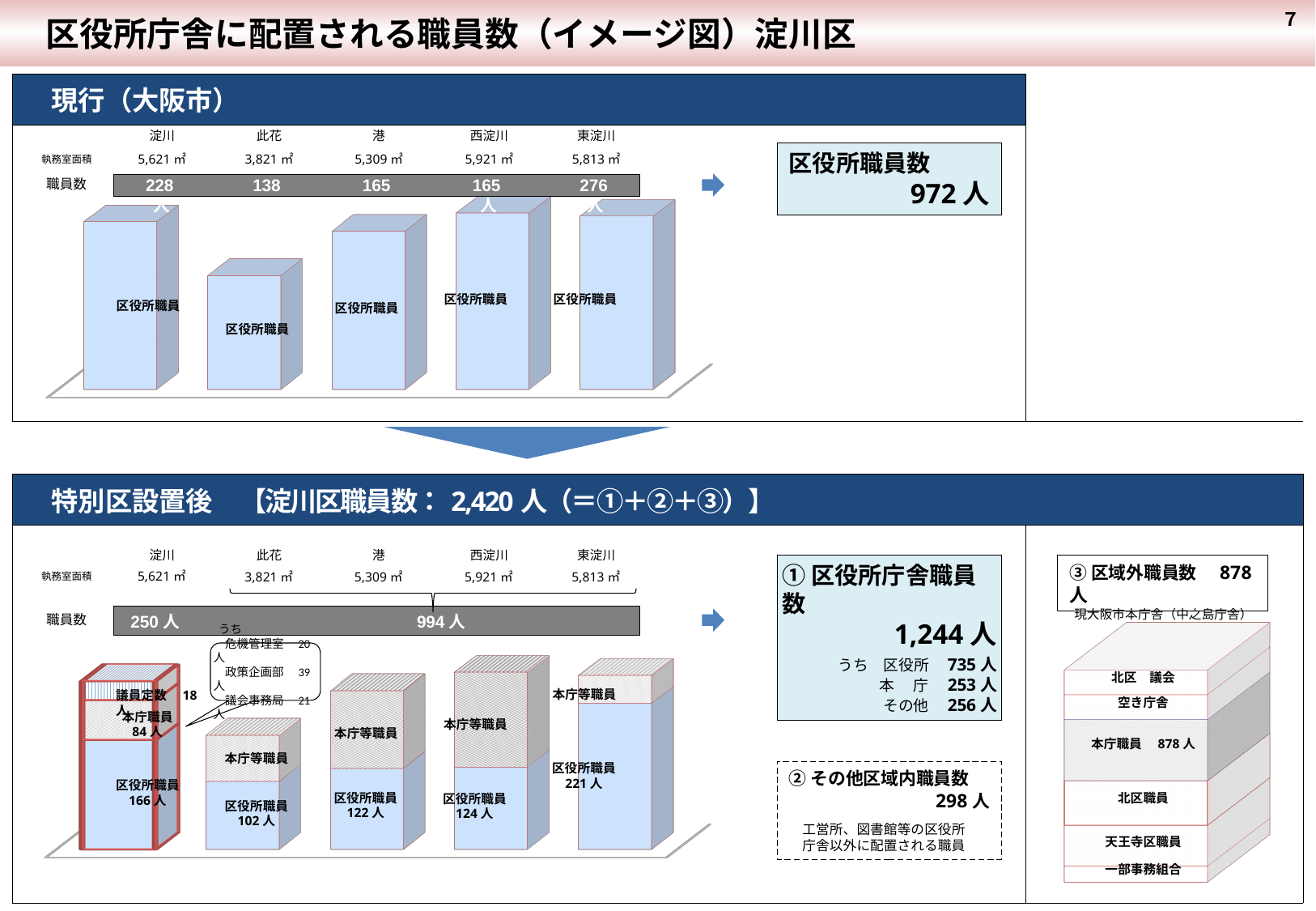
In the top chart (現行（大阪市）), what is the 職員数 value for 東淀川? 276 In the bottom chart (特別区設置後), what is the 区役所職員 value for 港? 122 人 In the bottom chart (特別区設置後), which ward has the highest 区役所職員 value? 東淀川 In the bottom chart (特別区設置後), what is the 本庁職員 value shown for 淀川? 84 人 In the bottom chart (特別区設置後), what is the total 職員数 shown for 淀川 in the gray bar? 250 人 In the top chart (現行（大阪市）), what is the difference in 職員数 between 東淀川 and 此花? 138 In the top chart (現行（大阪市）), how many wards are shown? 5 In the top chart (現行（大阪市）), which ward has the lowest 職員数? 此花 In the top chart (現行（大阪市）), what is the total 区役所職員数 shown in the box on the right? 972 人 In the bottom chart (特別区設置後), what is the difference in 区役所職員 between 東淀川 and 此花? 119 人 In the top chart (現行（大阪市）), which ward has the highest 職員数? 東淀川 In the top chart (現行（大阪市）), which has the larger 職員数, 淀川 or 此花? 淀川